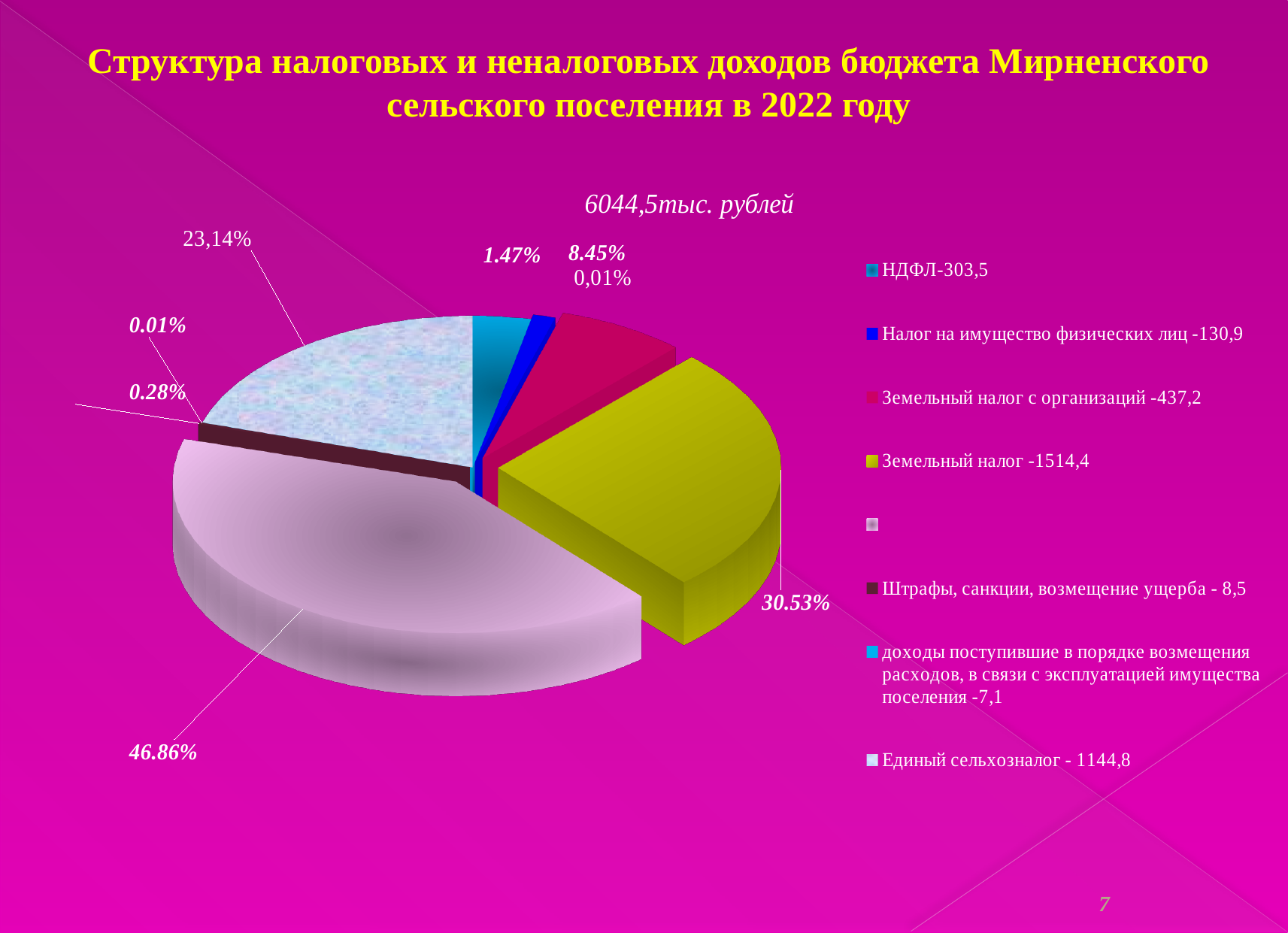
Which is larger according to the legend: Земельный налог с организаций or НДФЛ? Земельный налог с организаций What total amount is printed above the pie chart? 6044,5тыс. рублей What value is given in the legend for Штрафы, санкции, возмещение ущерба? 8,5 What percentage label is shown on the yellow slice (Земельный налог)? 30.53% What value is given in the legend for НДФЛ? 303,5 Which legend entry has the largest value? Земельный налог What value is given in the legend for Единый сельхозналог? 1144,8 What kind of chart is shown on the slide? pie chart What value is given in the legend for Земельный налог? 1514,4 What is the difference between the legend values for Земельный налог and Единый сельхозналог? 369,6 Which legend entry has the smallest value? доходы поступившие в порядке возмещения расходов, в связи с эксплуатацией имущества поселения What percentage label is shown on the largest slice of the pie? 46.86%